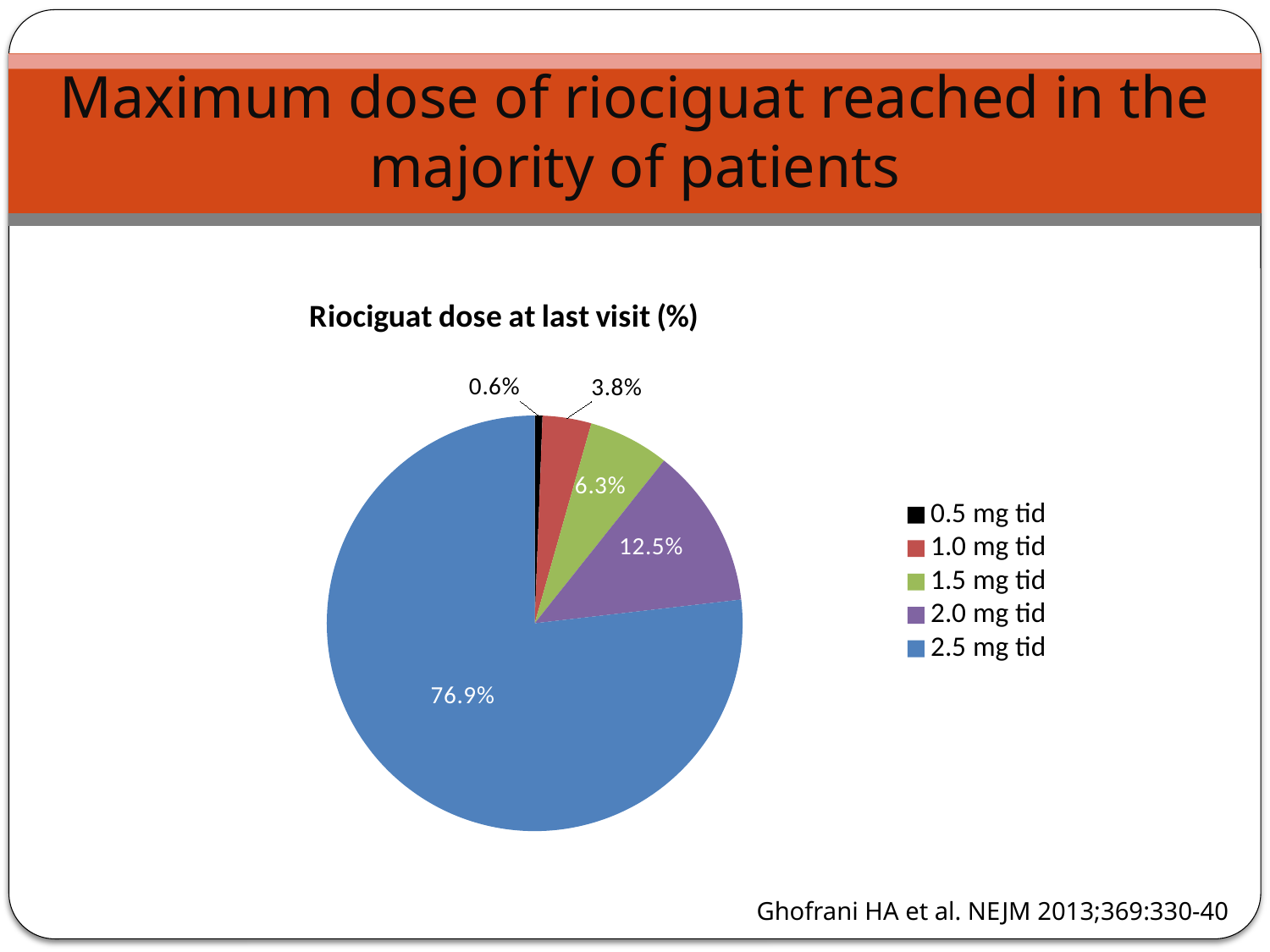
What type of chart is shown on the slide? pie chart What percentage of patients were on 1.5 mg tid at the last visit? 6.3% What percentage of patients were on 2.0 mg tid at the last visit? 12.5% What is the difference in percentage points between the 2.0 mg tid and 1.5 mg tid slices? 6.2 What is the chart's title? Riociguat dose at last visit (%) Which dose category has the largest share of the pie? 2.5 mg tid Which dose category has the smallest share of the pie? 0.5 mg tid Which slice is larger, 1.0 mg tid or 2.0 mg tid? 2.0 mg tid What percentage of patients were on 0.5 mg tid at the last visit? 0.6% How many dose categories does the legend list? 5 What percentage of patients were on 2.5 mg tid at the last visit? 76.9% What percentage of patients were on 1.0 mg tid at the last visit? 3.8%